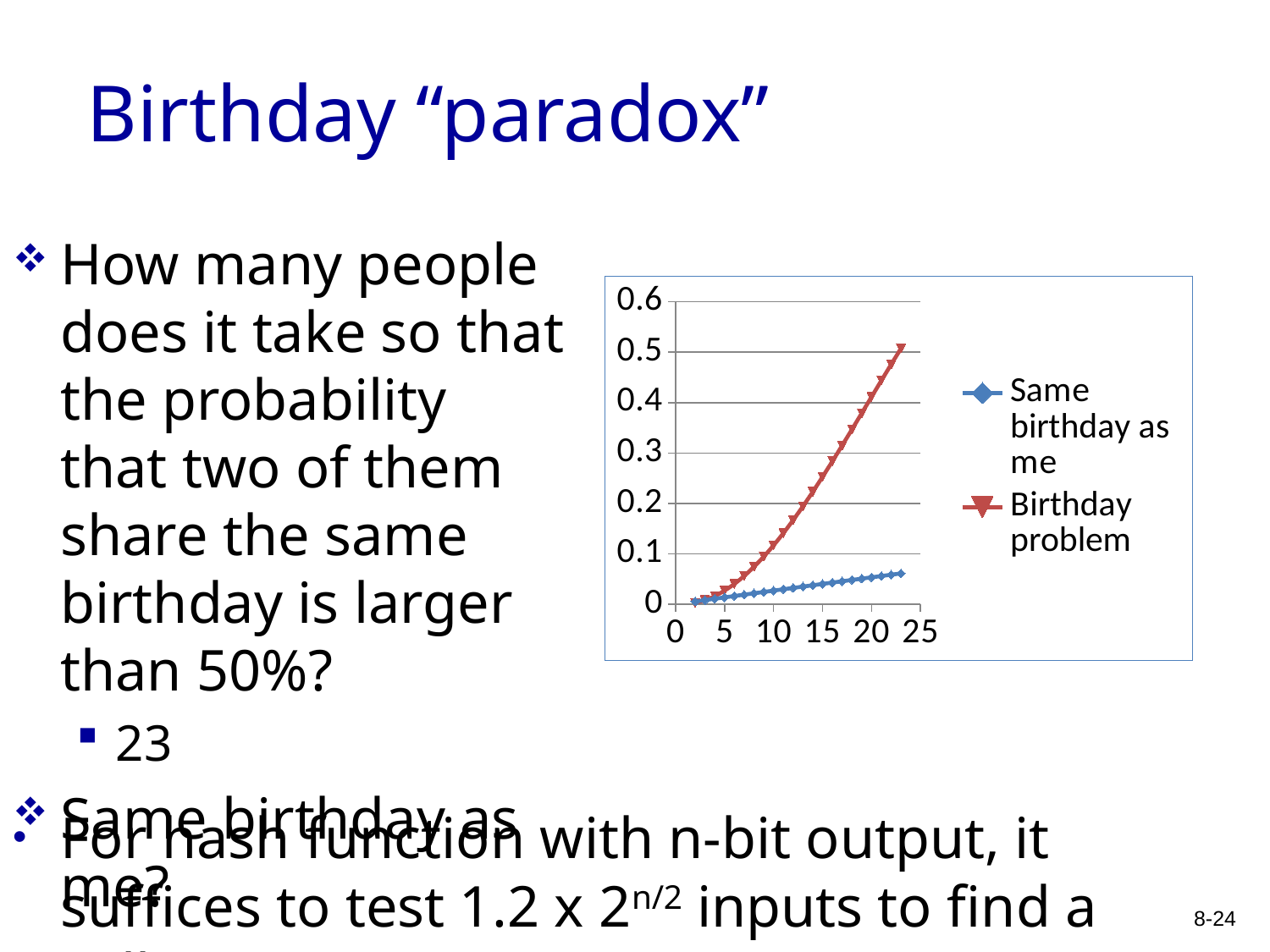
Does the Same birthday as me series rise or fall as the x value increases? rise Which series in the chart is drawn in red with triangle markers? Birthday problem Does the Birthday problem series rise or fall as the x value increases? rise Is the value of the Birthday problem series at x = 5 greater or less than 0.1? less Is the value of the Same birthday as me series at x = 20 greater or less than 0.1? less How many series does the chart's legend list? 2 Is the value of the Birthday problem series at x = 15 greater or less than 0.2? greater What are the two series named in the chart's legend? Same birthday as me; Birthday problem Which series reaches the higher value at the right end of the chart? Birthday problem At x = 20, which series has the larger value, Birthday problem or Same birthday as me? Birthday problem What kind of chart is shown on the slide? line chart